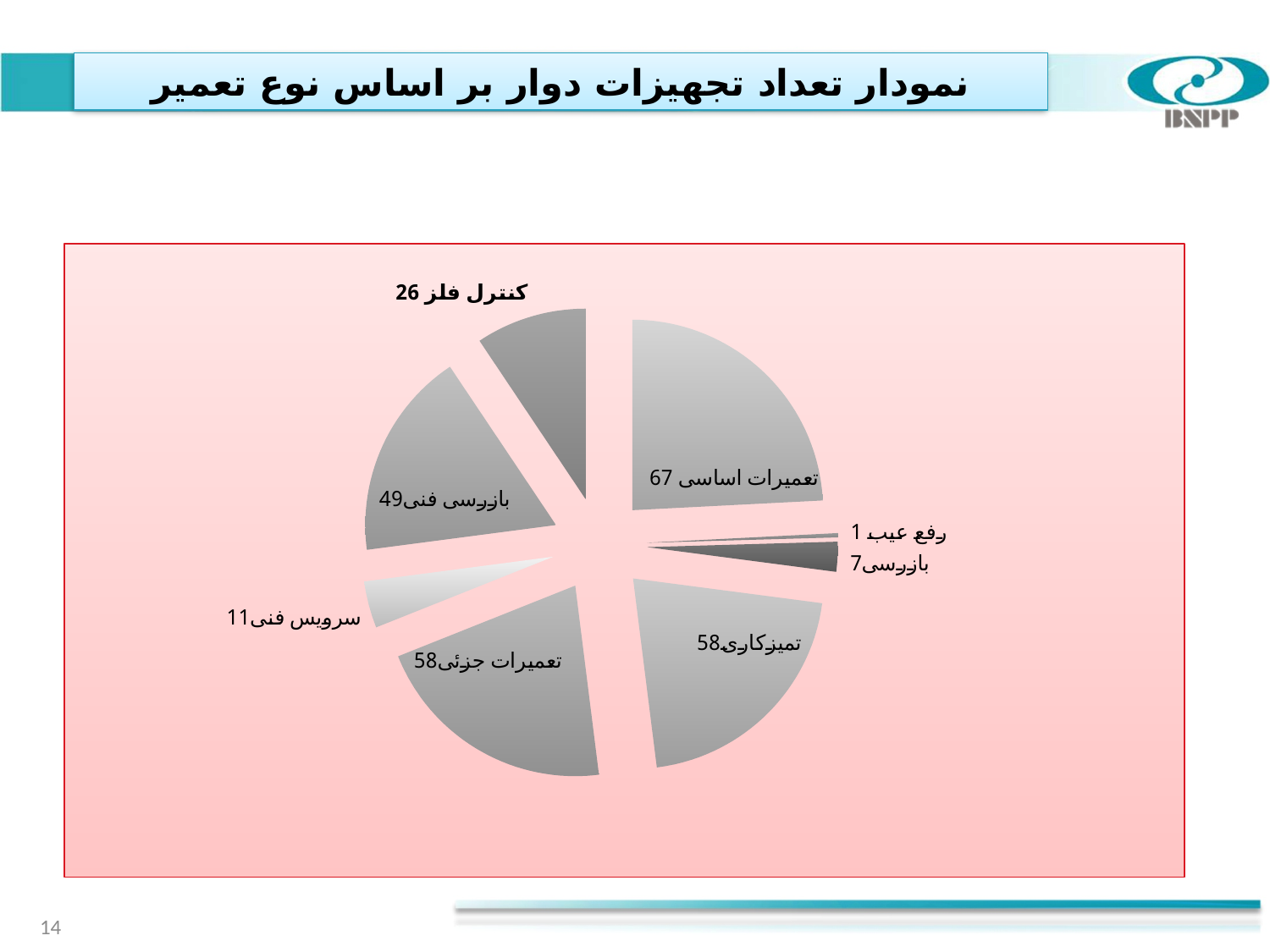
Which category has the largest slice of the pie? تعمیرات اساسی What is the value for بازرسی فنی? 49 What is the difference between the values for تعمیرات اساسی and بازرسی فنی? 18 What is the value for سرویس فنی? 11 Which is larger, the value for کنترل فلز or the value for بازرسی? کنترل فلز What is the difference between the values for تمیزکاری and سرویس فنی? 47 Which category has the smallest slice of the pie? رفع عیب How many categories (slices) does the pie chart have? 8 What is the value for تعمیرات اساسی? 67 What is the value for کنترل فلز? 26 What is the title of the slide? نمودار تعداد تجهیزات دوار بر اساس نوع تعمیر What type of chart is shown on the slide? pie chart